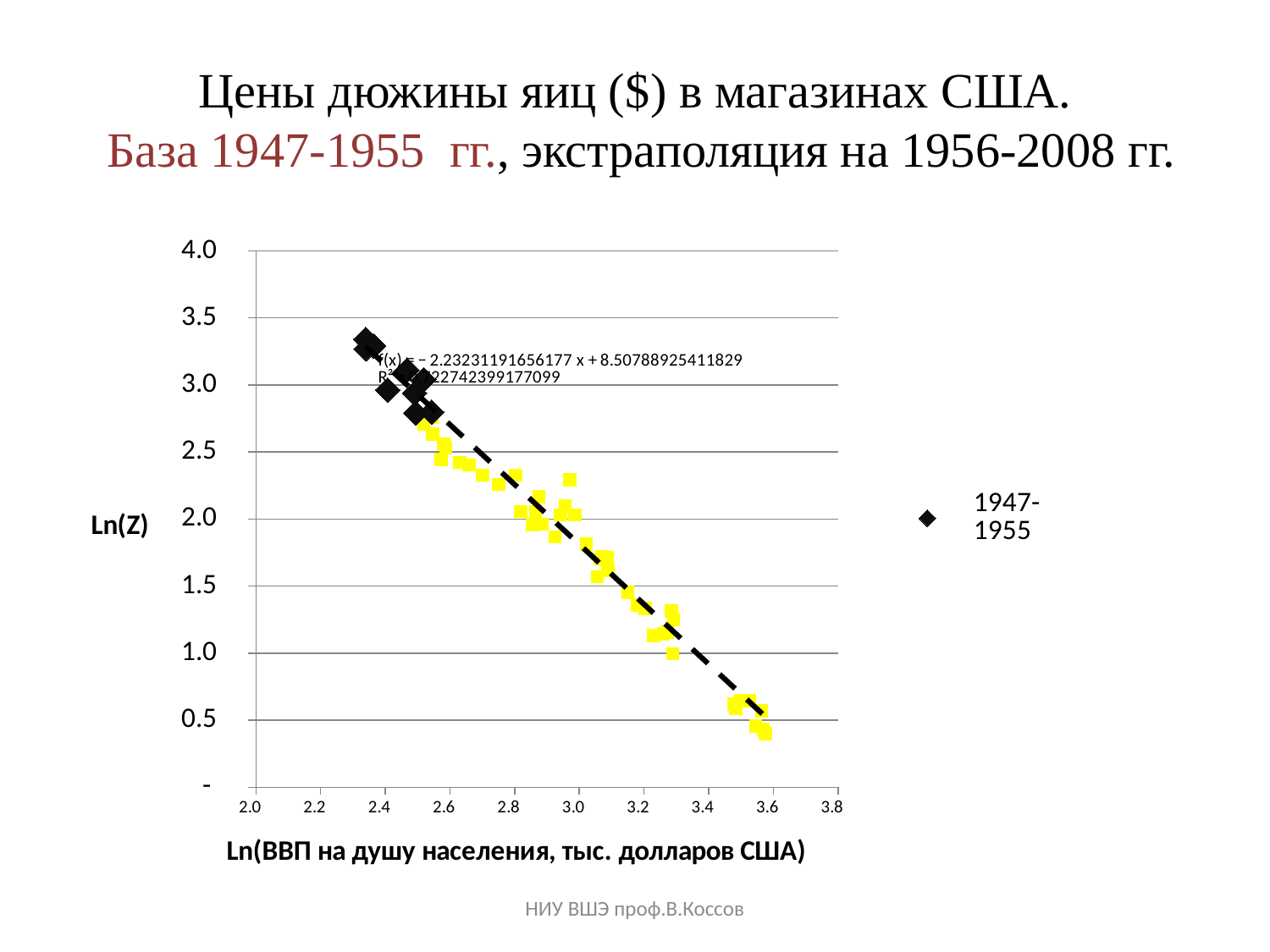
How many series does the chart's legend list? 1 Are the Ln(Z) values of the yellow points near x = 3.5 greater or less than 1.0? less What kind of chart is shown on the slide? scatter chart As Ln(ВВП на душу населения) increases along the x axis, do the Ln(Z) values rise or fall? fall Which group of points has higher Ln(Z) values: the black 1947-1955 points or the yellow points? the black 1947-1955 points What is the label of the series shown in the legend? 1947-1955 What is the intercept of the fitted trend line equation shown on the chart? 8.50788925411829 What is the lowest value shown on the horizontal axis? 2.0 What is the title of the vertical axis? Ln(Z) What is the slope of the fitted trend line equation shown on the chart? -2.23231191656177 What is the highest value shown on the vertical axis? 4.0 Are the Ln(Z) values of the black 1947-1955 points greater or less than 2.5? greater